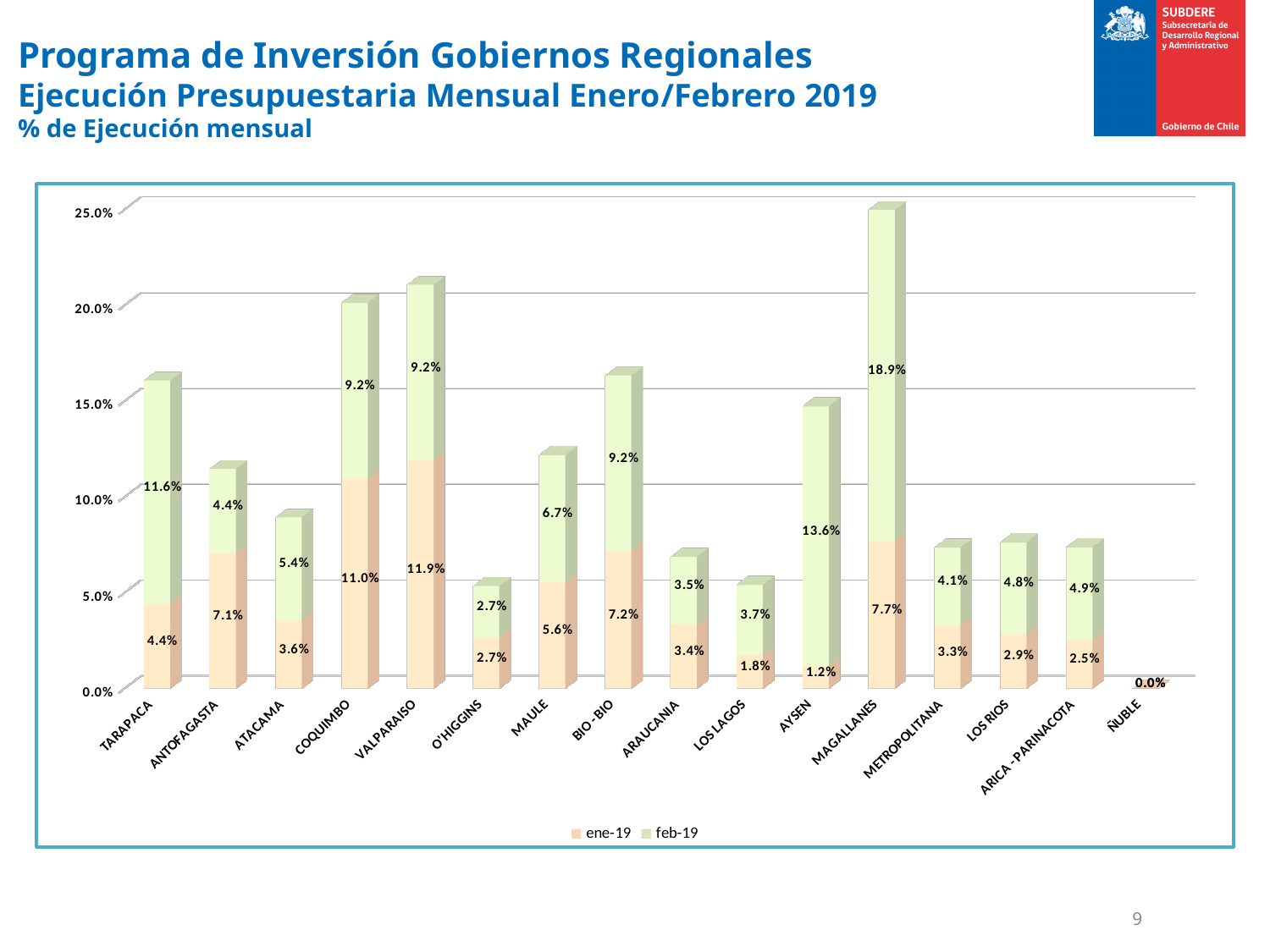
What is the feb-19 value for AYSEN? 13.6% What is the feb-19 value for MAGALLANES? 18.9% How many series does the legend list? 2 What kind of chart is shown on the slide? Stacked bar chart How many regions are shown on the x axis? 16 Which is larger for ANTOFAGASTA: the ene-19 value or the feb-19 value? ene-19 What is the ene-19 value for VALPARAISO? 11.9% What is the total of the stacked bar for MAGALLANES? 26.6% Which region has the lowest ene-19 value among those with a non-zero value? AYSEN Which region has the highest feb-19 value? MAGALLANES What is the difference between the feb-19 and ene-19 values for TARAPACA? 7.2% What is the total of the stacked bar for COQUIMBO? 20.2%